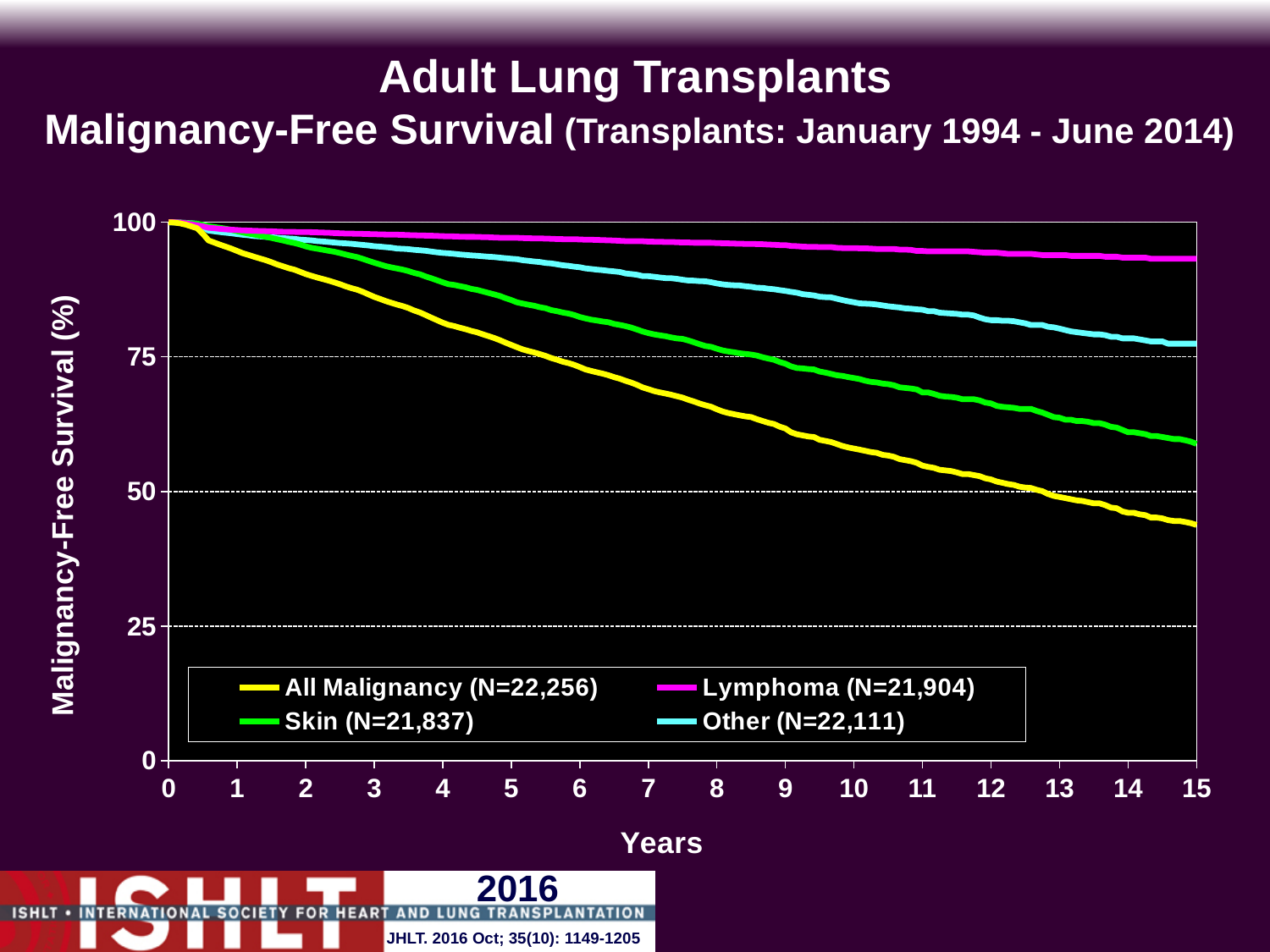
At 15 years, which series has higher malignancy-free survival, Lymphoma or Skin? Lymphoma What is the label of the y axis? Malignancy-Free Survival (%) Is the malignancy-free survival for Other at 10 years greater or less than 75? greater Is the malignancy-free survival for Skin at 15 years greater or less than 50? greater How many series does the legend list? 4 Is the malignancy-free survival for Skin at 10 years greater or less than 75? less What kind of chart is shown on the slide? line chart Which series has the lowest malignancy-free survival at 15 years? All Malignancy (N=22,256) Which series has the highest malignancy-free survival at 15 years? Lymphoma (N=21,904) Do the survival curves rise or fall as the years increase along the x axis? fall What is the N value shown in the legend for the Skin series? 21,837